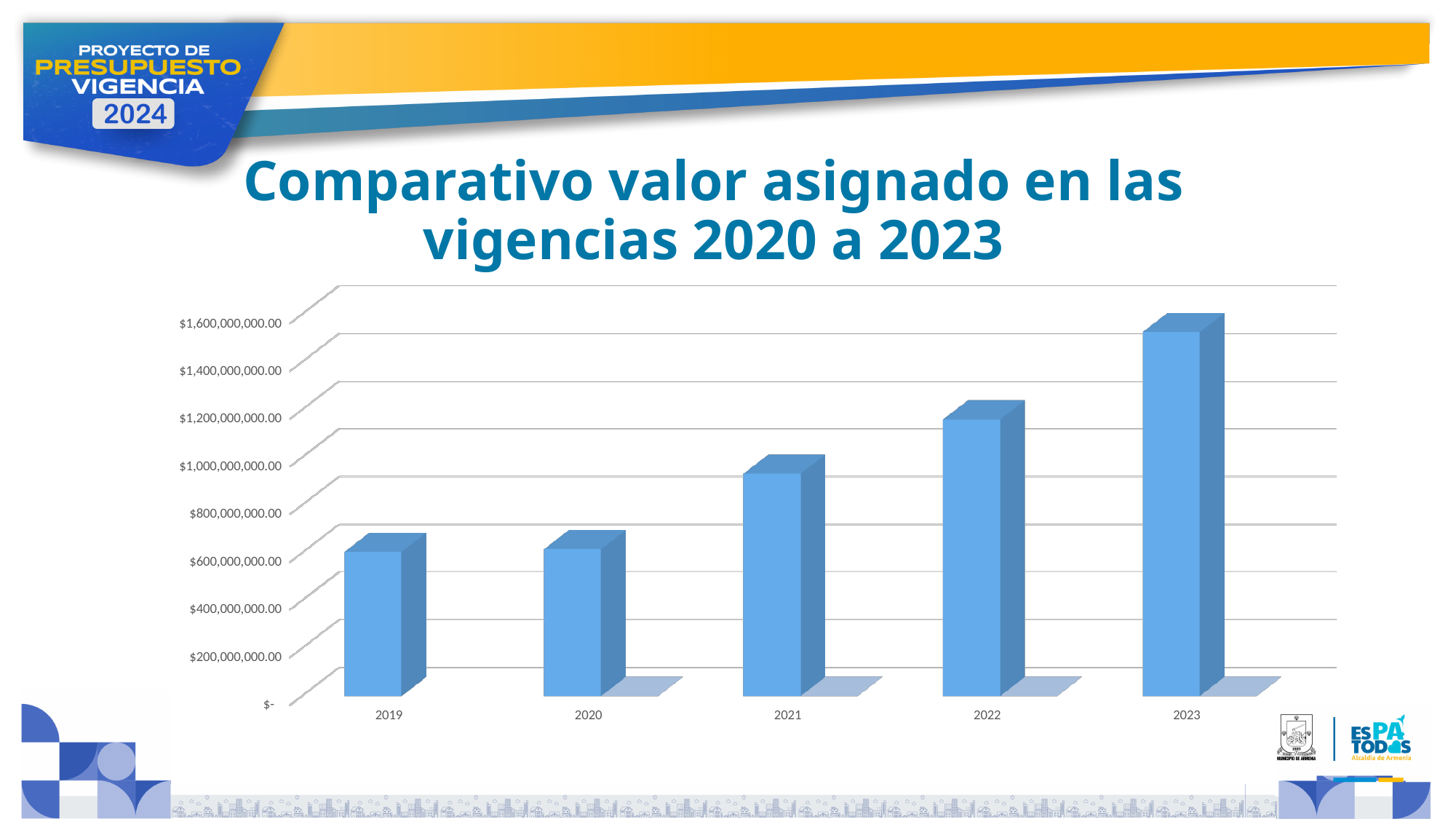
How many years are shown on the x axis of the chart? 5 What kind of chart is shown on the slide? Bar chart Which year has the highest value in the chart? 2023 Is the value for 2023 greater or less than $1,400,000,000.00? greater Which is larger, the value for 2021 or the value for 2022? 2022 What is the title of the chart on the slide? Comparativo valor asignado en las vigencias 2020 a 2023 Is the value for 2021 greater or less than $800,000,000.00? greater Is the value for 2020 greater or less than $800,000,000.00? less Which is larger, the value for 2019 or the value for 2023? 2023 Do the values rise or fall from 2019 to 2023? Rise